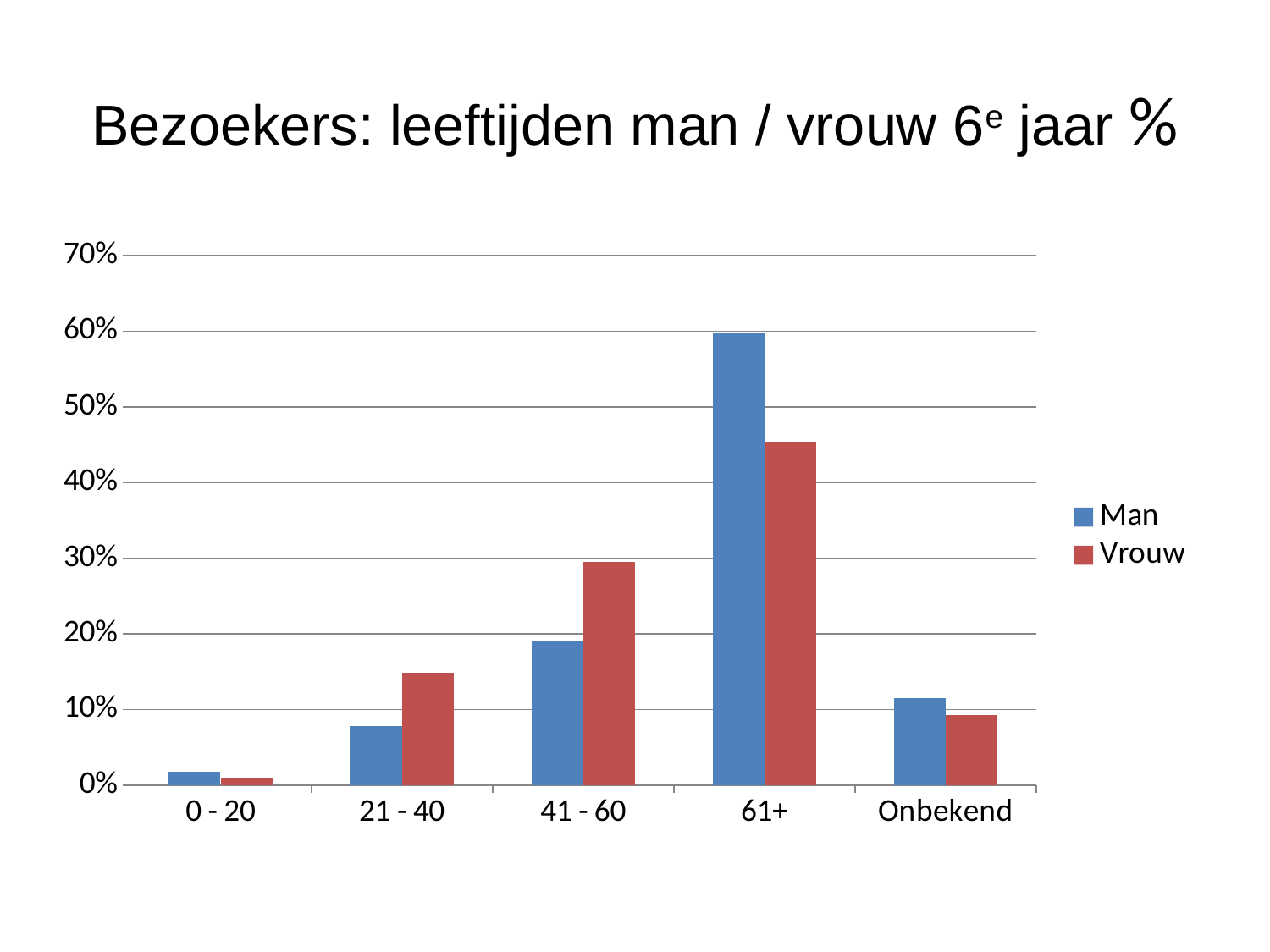
In the 61+ category, which is larger: Man or Vrouw? Man Which age category has the lowest value for Vrouw? 0 - 20 What kind of chart is shown on the slide? bar chart How many age categories are shown on the x axis? 5 Which colour represents the Vrouw series in the legend? red Is the value for Vrouw in the 41 - 60 category greater or less than 20%? greater Is the value for Vrouw in the 61+ category greater or less than 40%? greater How many series does the legend list? 2 In the 21 - 40 category, which is larger: Man or Vrouw? Vrouw Which age category has the highest value for Man? 61+ Is the value for Man in the 21 - 40 category greater or less than 10%? less